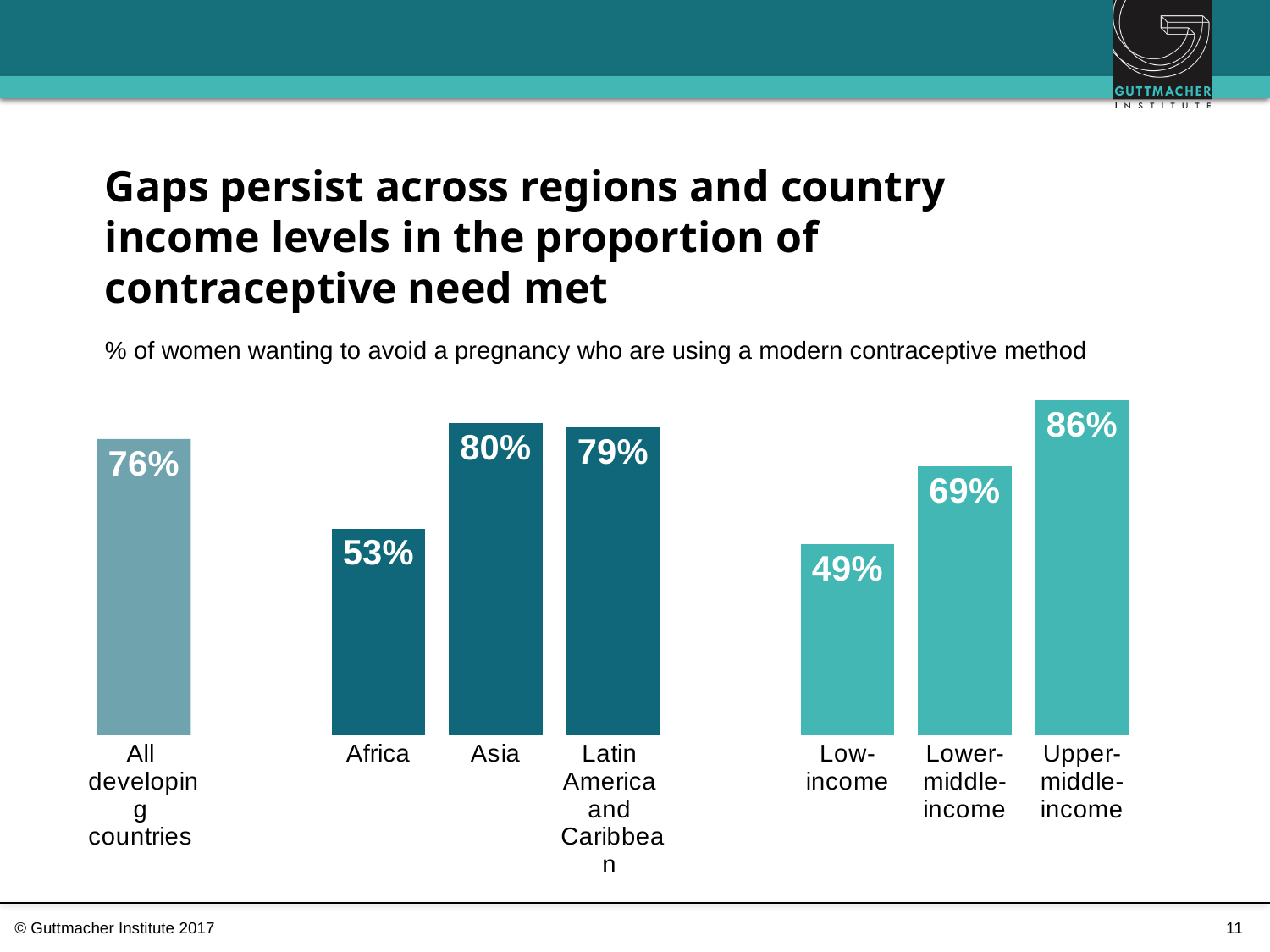
Do the values rise or fall from Low-income to Upper-middle-income? Rise What is the difference between the values for Asia and Africa? 27% What is the value for Upper-middle-income countries? 86% What kind of chart is shown on the slide? Bar chart Which is larger, the value for Lower-middle-income or the value for Africa? Lower-middle-income Which category has the highest value? Upper-middle-income How many categories are shown in the chart? 7 What is the value for All developing countries? 76% What is the difference between the values for Upper-middle-income and Low-income? 37% What is the value for Latin America and Caribbean? 79% Which category has the lowest value? Low-income What is the value for Africa? 53%